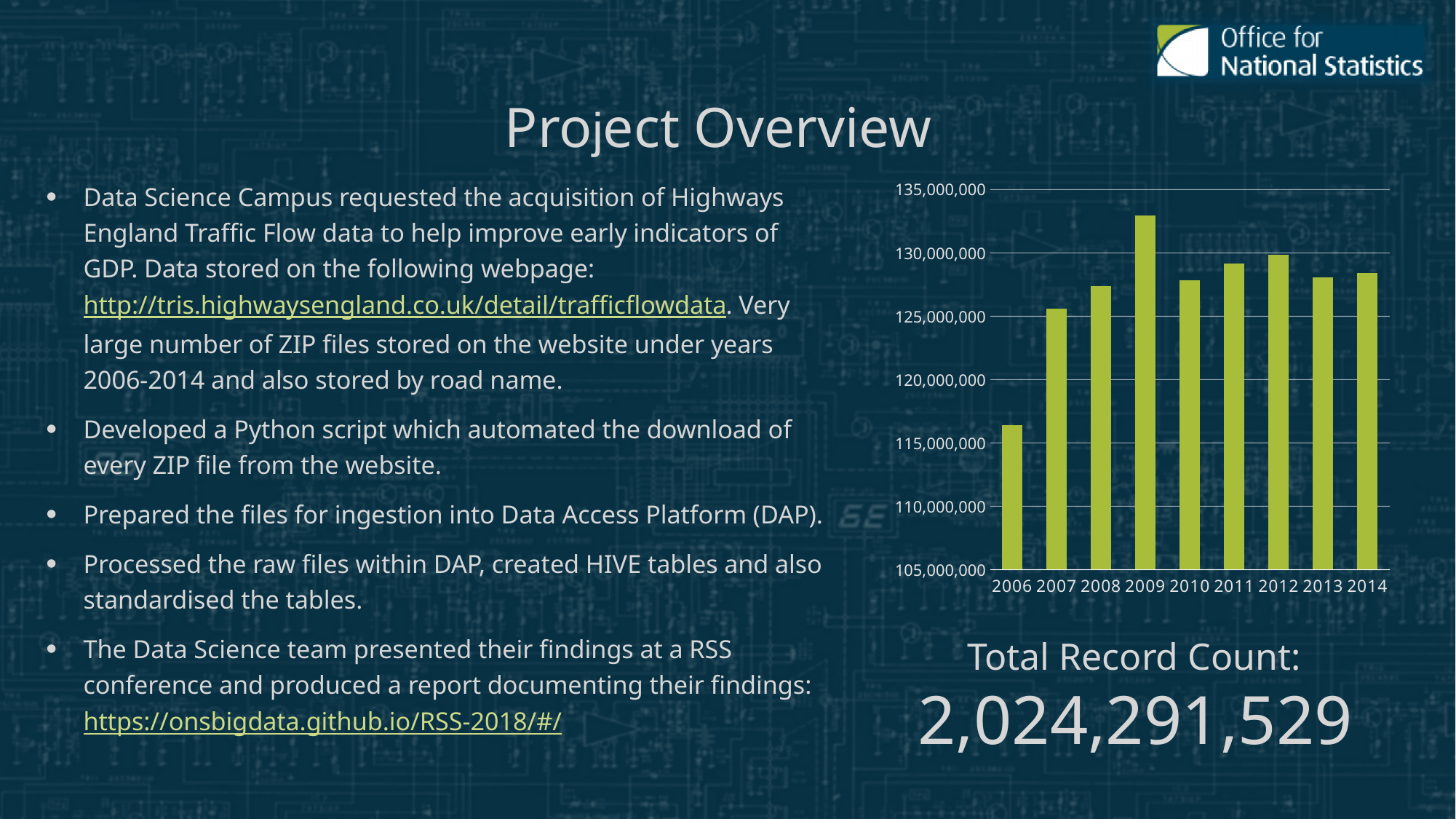
Do the values rise or fall from 2006 to 2009? rise Is the value for 2006 greater or less than 120,000,000? less Is the value for 2009 greater or less than 130,000,000? greater How many years are plotted on the chart? 9 What is the lowest value shown on the chart's vertical axis? 105,000,000 Which year has the larger value, 2006 or 2007? 2007 Which year has the highest bar on the chart? 2009 Which year has the lowest bar on the chart? 2006 Is the value for 2014 greater or less than 130,000,000? less Which year has the larger value, 2009 or 2012? 2009 What kind of chart is shown on the slide? Bar chart